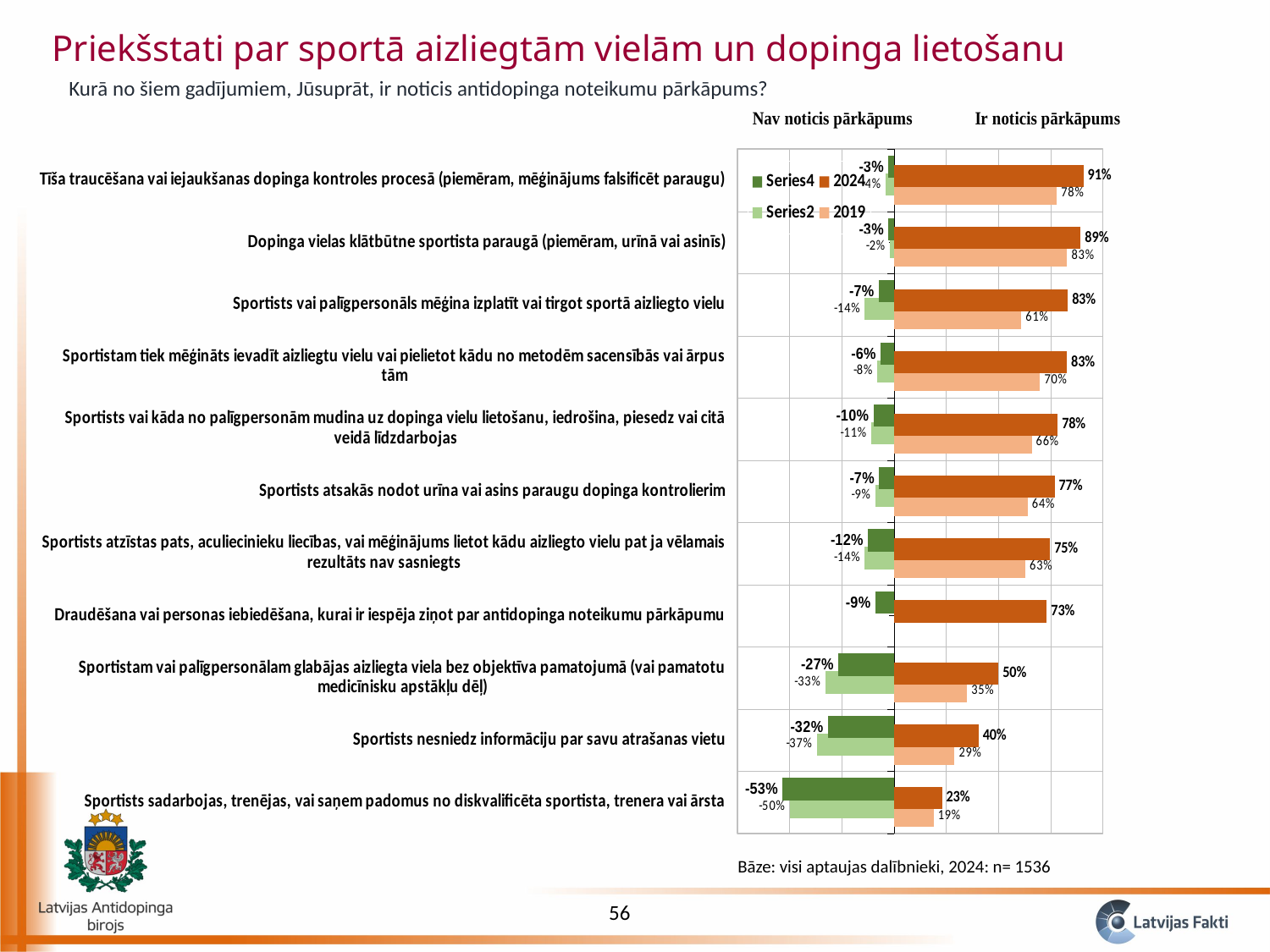
How many series does the chart legend list? 4 How many categories (statements) are shown in the chart? 11 What is the 2024 "Ir noticis pārkāpums" value for "Tīša traucēšana vai iejaukšanas dopinga kontroles procesā"? 91% Which category has the lowest 2024 "Ir noticis pārkāpums" value? Sportists sadarbojas, trenējas, vai saņem padomus no diskvalificēta sportista, trenera vai ārsta What is the 2024 "Ir noticis pārkāpums" value for "Sportists nesniedz informāciju par savu atrašanas vietu"? 40% What is the 2019 "Ir noticis pārkāpums" value for "Sportists vai palīgpersonāls mēģina izplatīt vai tirgot sportā aizliegto vielu"? 61% What kind of chart is shown on the slide? Bar chart What is the difference between the 2024 and 2019 "Ir noticis pārkāpums" values for "Sportists vai palīgpersonāls mēģina izplatīt vai tirgot sportā aizliegto vielu"? 22 percentage points Which is larger for "Sportistam vai palīgpersonālam glabājas aizliegta viela bez objektīva pamatojuma": the 2024 or the 2019 "Ir noticis pārkāpums" value? 2024 What is the 2019 "Ir noticis pārkāpums" value for "Sportists atsakās nodot urīna vai asins paraugu dopinga kontrolierim"? 64% What is the 2024 "Nav noticis pārkāpums" value for "Sportists sadarbojas, trenējas, vai saņem padomus no diskvalificēta sportista, trenera vai ārsta"? -53% Which category has the highest 2024 "Ir noticis pārkāpums" value? Tīša traucēšana vai iejaukšanas dopinga kontroles procesā (piemēram, mēģinājums falsificēt paraugu)